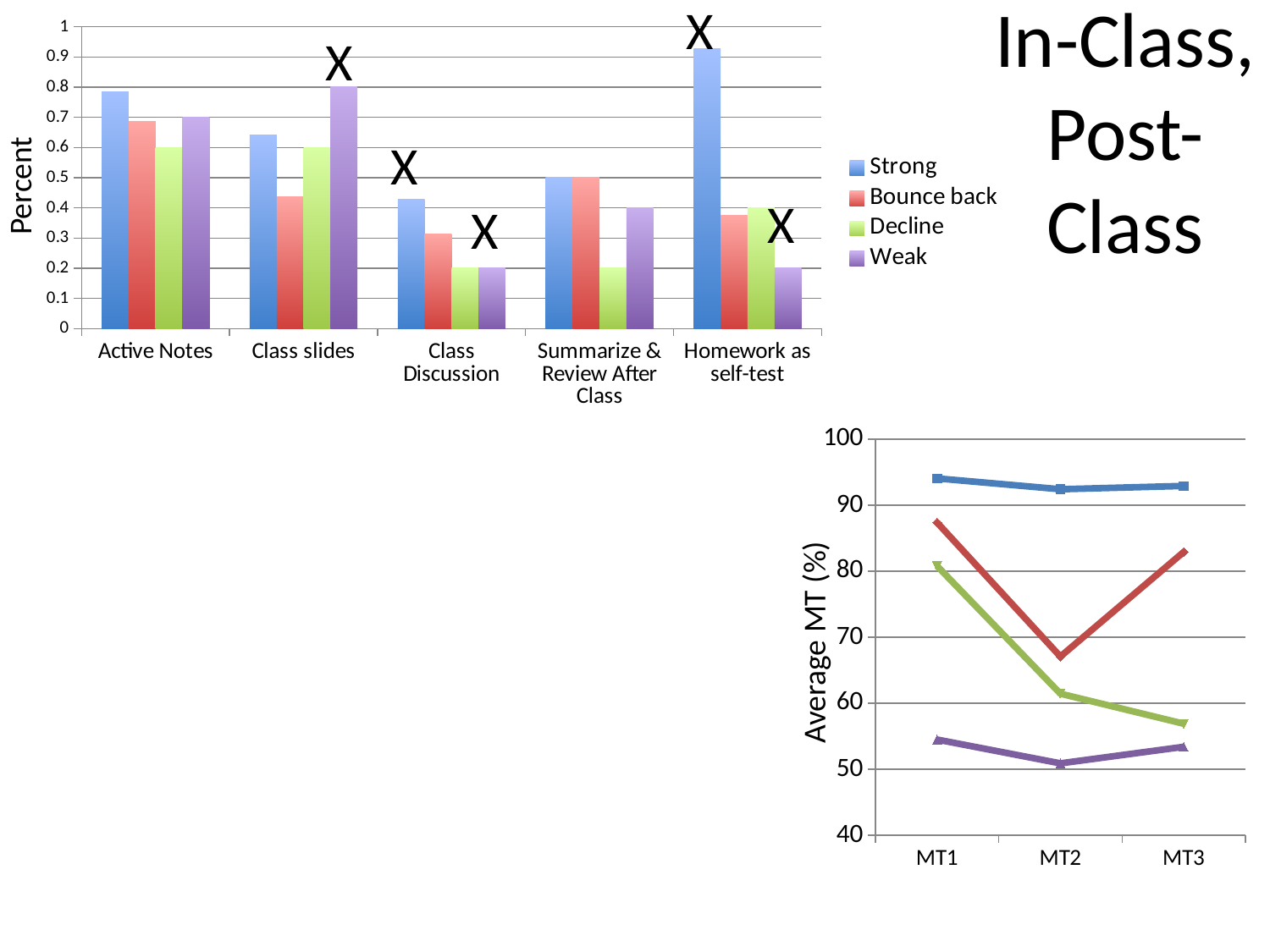
In the top-left bar chart, which category has the highest Strong value? Homework as self-test In the top-left bar chart, how many series does the legend list? 4 In the top-left bar chart, is the Strong value for Homework as self-test greater or less than 0.9? greater In the top-left bar chart, for Class slides, which is larger: the Weak value or the Strong value? Weak What kind of chart is the bottom-right chart with the 'Average MT (%)' axis? line chart In the bottom-right line chart, is the red line's value at MT2 greater or less than 70? less In the top-left bar chart, which category has the lowest Strong value? Class Discussion In the top-left bar chart, how many categories are shown on the x axis? 5 In the top-left bar chart, is the Bounce back value for Class slides greater or less than 0.5? less In the bottom-right line chart, does the green line rise or fall from MT1 to MT3? fall In the bottom-right line chart, how many points are on the x axis? 3 What kind of chart is the top-left chart with the 'Percent' axis? bar chart